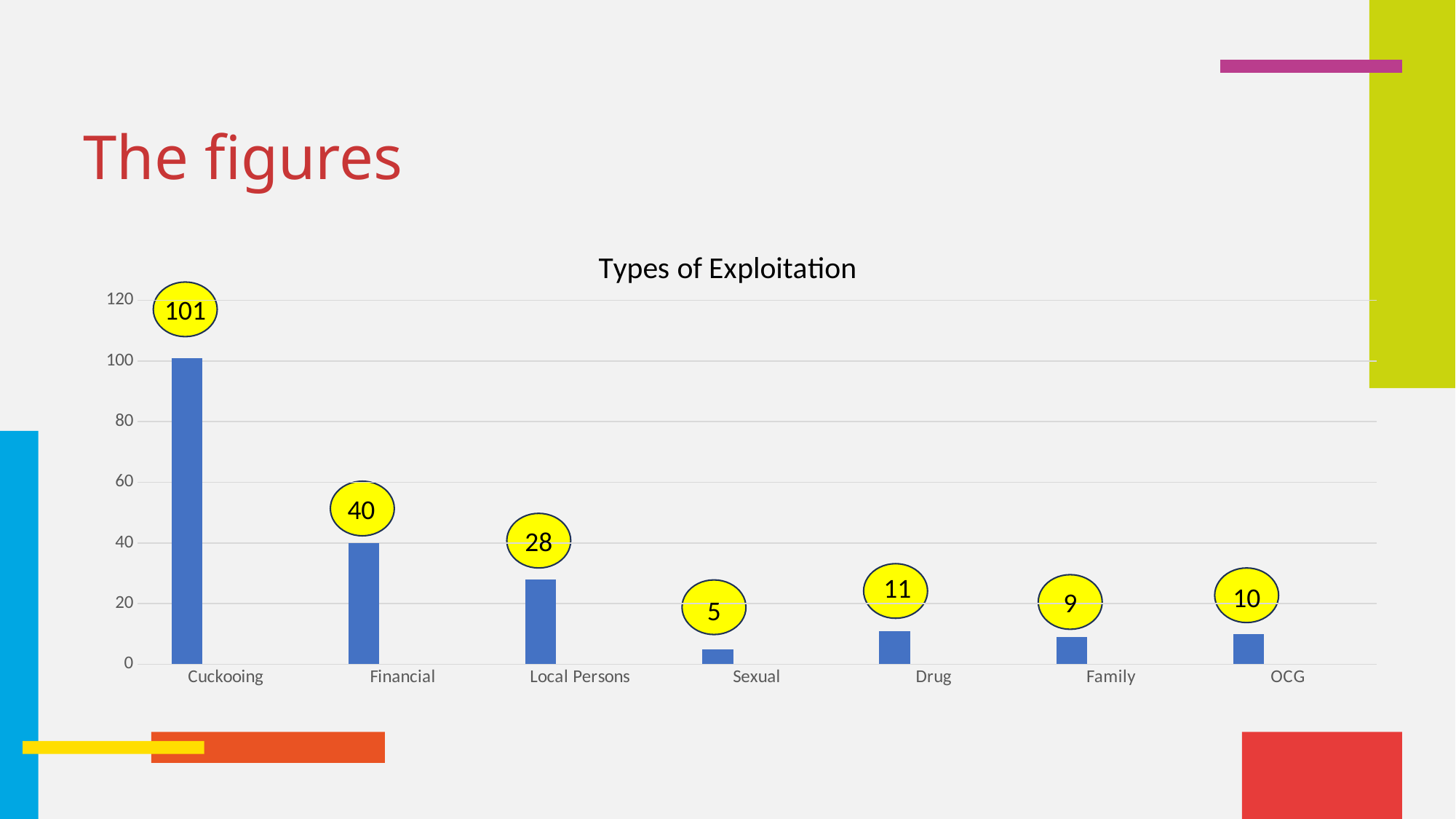
What is the value for Sexual? 5 What is the value for Cuckooing? 101 What is the difference between the values for Cuckooing and Financial? 61 Which is larger, the value for Drug or the value for OCG? Drug What is the title of the chart? Types of Exploitation What kind of chart is this? Bar chart What is the value for Financial? 40 How many categories are shown on the x axis? 7 Which category has the highest value? Cuckooing What is the value for Local Persons? 28 What is the difference between the values for Drug and Family? 2 Which category has the lowest value? Sexual